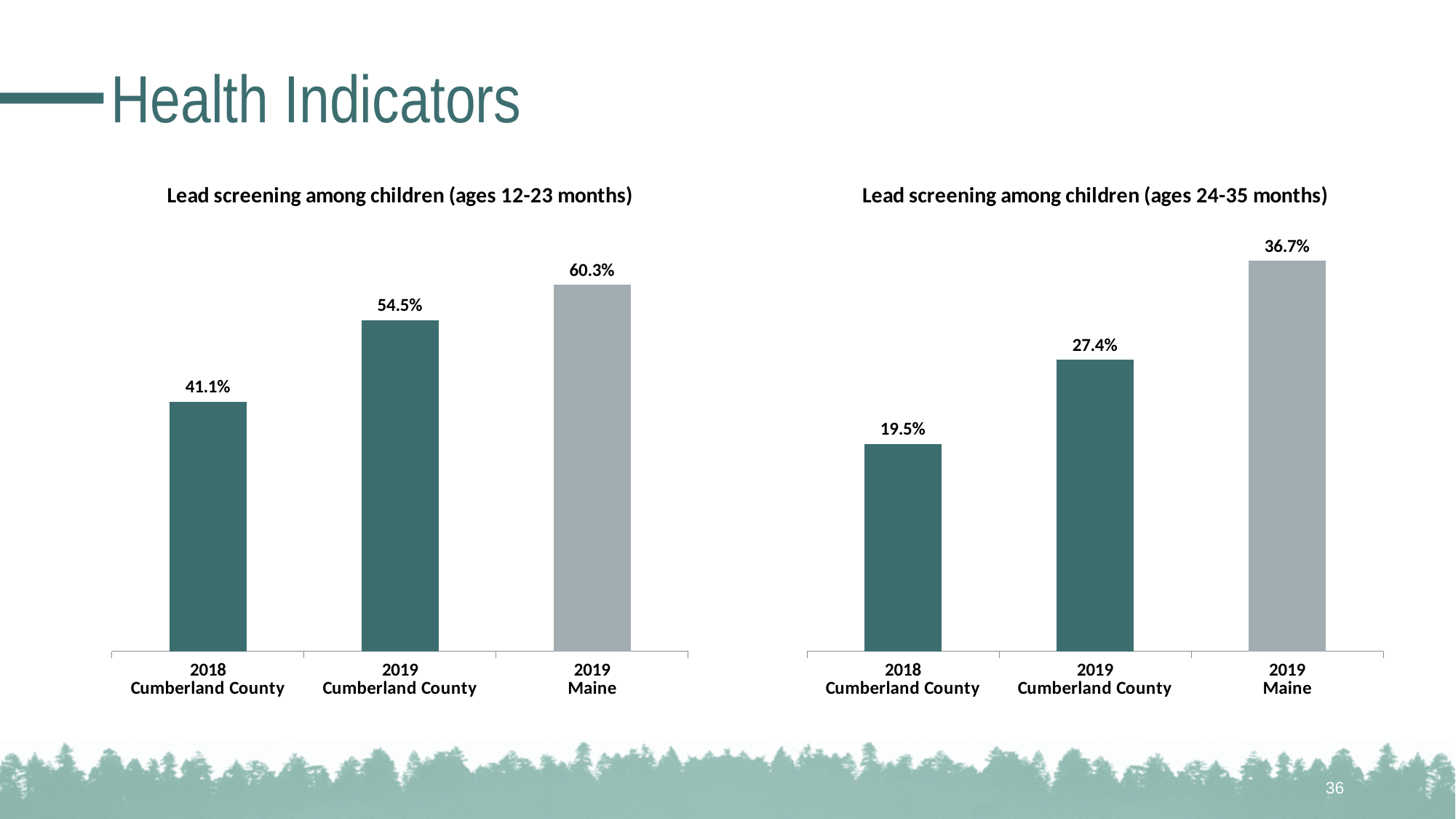
How many bars are in the 'Lead screening among children (ages 12-23 months)' chart? 3 In the 'Lead screening among children (ages 12-23 months)' chart, what is the value for 2018 Cumberland County? 41.1% In the 'Lead screening among children (ages 24-35 months)' chart, what is the value for 2018 Cumberland County? 19.5% In the 'Lead screening among children (ages 12-23 months)' chart, what is the value for 2019 Cumberland County? 54.5% In the 'Lead screening among children (ages 12-23 months)' chart, what is the difference between the 2019 Cumberland County value and the 2018 Cumberland County value? 13.4% In the 'Lead screening among children (ages 24-35 months)' chart, what is the value for 2019 Maine? 36.7% In the 'Lead screening among children (ages 24-35 months)' chart, which category has the lowest value? 2018 Cumberland County In the 'Lead screening among children (ages 12-23 months)' chart, which category has the highest value? 2019 Maine In the 'Lead screening among children (ages 24-35 months)' chart, which is larger: the value for 2019 Cumberland County or the value for 2018 Cumberland County? 2019 Cumberland County What type of chart is the 'Lead screening among children (ages 24-35 months)' chart? Bar chart In the 'Lead screening among children (ages 12-23 months)' chart, do the values rise or fall from left to right? Rise In the 'Lead screening among children (ages 24-35 months)' chart, what is the difference between the 2019 Maine value and the 2019 Cumberland County value? 9.3%